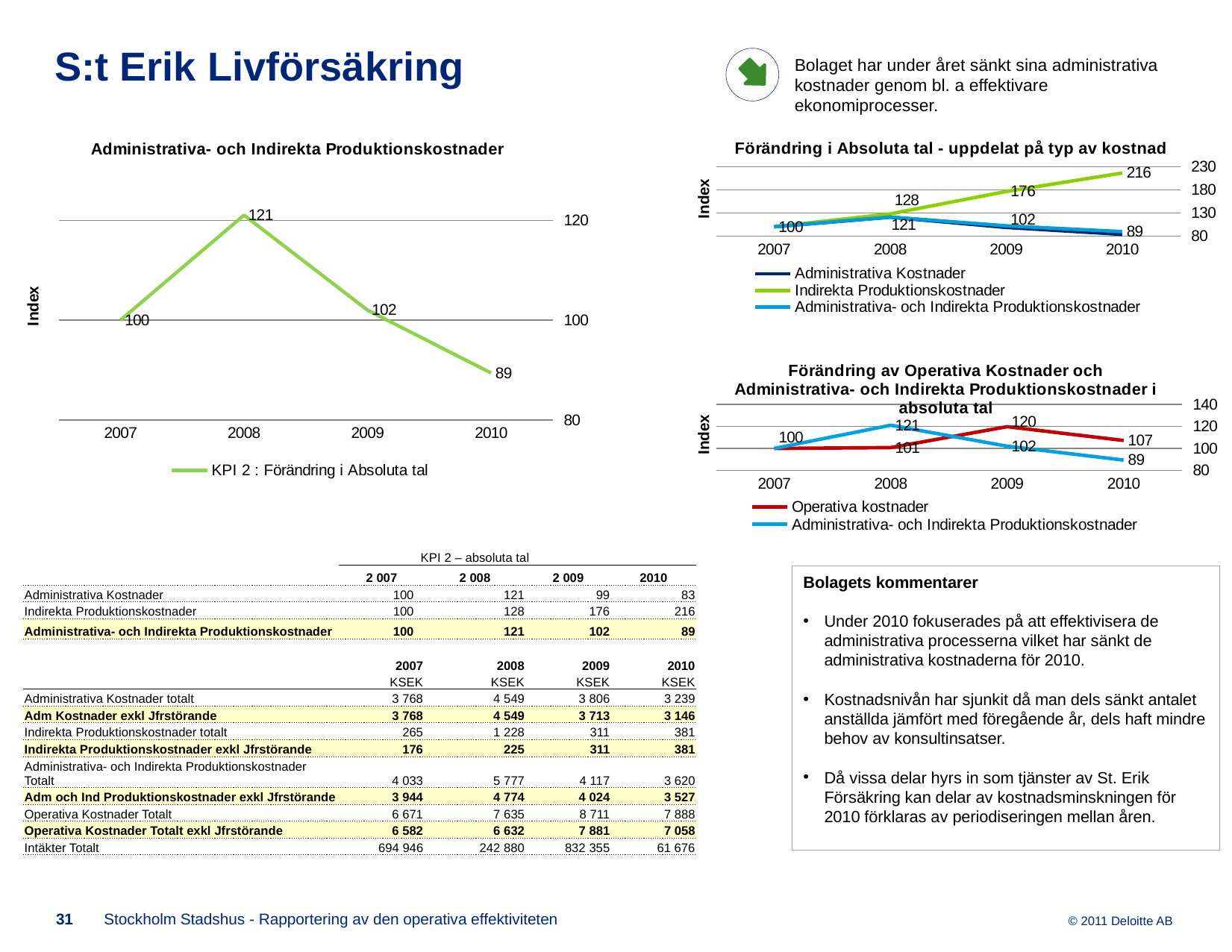
In the chart titled 'Förändring av Operativa Kostnader och Administrativa- och Indirekta Produktionskostnader i absoluta tal', which is larger in 2010: Operativa kostnader or Administrativa- och Indirekta Produktionskostnader? Operativa kostnader In the chart titled 'Förändring av Operativa Kostnader och Administrativa- och Indirekta Produktionskostnader i absoluta tal', what is the value of Operativa kostnader in 2009? 120 What kind of chart is the chart titled 'Administrativa- och Indirekta Produktionskostnader'? Line chart In the chart titled 'Administrativa- och Indirekta Produktionskostnader', what is the value for 2008? 121 In the chart titled 'Förändring i Absoluta tal - uppdelat på typ av kostnad', does the Indirekta Produktionskostnader line rise or fall from 2007 to 2010? Rise In the chart titled 'Förändring i Absoluta tal - uppdelat på typ av kostnad', how many series does the legend list? 3 In the chart titled 'Administrativa- och Indirekta Produktionskostnader', how many years are plotted on the x axis? 4 In the chart titled 'Administrativa- och Indirekta Produktionskostnader', what is the difference between the 2008 value and the 2010 value? 32 In the chart titled 'Administrativa- och Indirekta Produktionskostnader', which year has the lowest value? 2010 In the chart titled 'Förändring i Absoluta tal - uppdelat på typ av kostnad', what is the value of Indirekta Produktionskostnader in 2010? 216 In the chart titled 'Förändring av Operativa Kostnader och Administrativa- och Indirekta Produktionskostnader i absoluta tal', what colour is the Operativa kostnader line? Red In the chart titled 'Förändring i Absoluta tal - uppdelat på typ av kostnad', what is the difference between Indirekta Produktionskostnader in 2009 and in 2008? 48